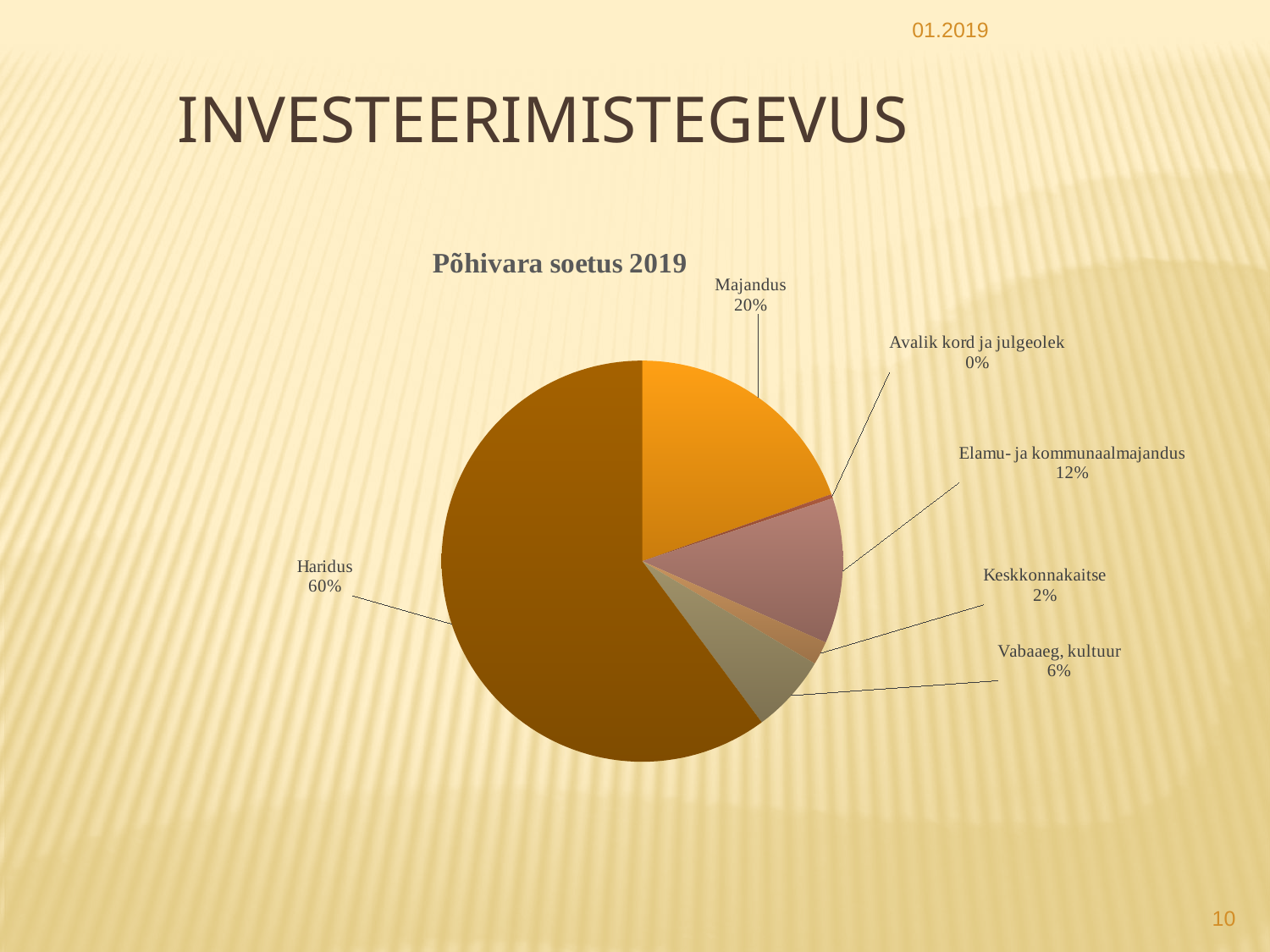
What share of the pie does Vabaaeg, kultuur have? 6% What share of the pie does Elamu- ja kommunaalmajandus have? 12% What kind of chart is shown on the slide? Pie chart How many categories are shown in the pie chart? 6 What share of the pie does Keskkonnakaitse have? 2% Which category has the smallest slice of the pie? Avalik kord ja julgeolek Which category has the largest slice of the pie? Haridus What is the difference in percentage points between Haridus and Majandus? 40 Which is larger, the share for Elamu- ja kommunaalmajandus or the share for Vabaaeg, kultuur? Elamu- ja kommunaalmajandus